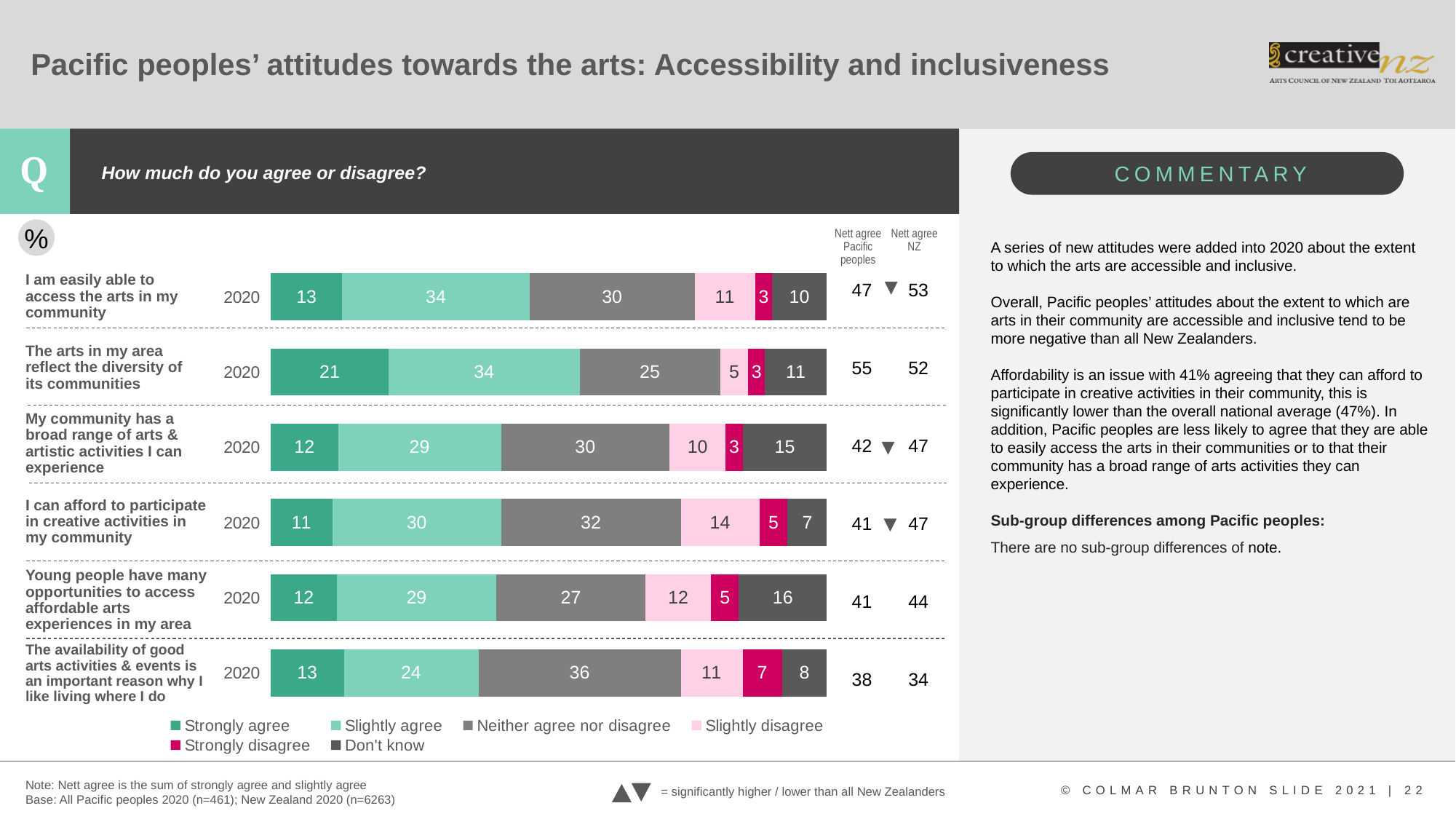
What is the Neither agree nor disagree value for "The availability of good arts activities & events is an important reason why I like living where I do"? 36 Which has the larger Neither agree nor disagree value: "I can afford to participate in creative activities in my community" or "Young people have many opportunities to access affordable arts experiences in my area"? I can afford to participate in creative activities in my community What is the Nett agree NZ value for "The availability of good arts activities & events is an important reason why I like living where I do"? 34 Which statement has the lowest Nett agree Pacific peoples value? The availability of good arts activities & events is an important reason why I like living where I do What kind of chart is shown on the slide? Stacked bar chart What is the Don't know value for "My community has a broad range of arts & artistic activities I can experience"? 15 Which statement has the highest Strongly disagree value? The availability of good arts activities & events is an important reason why I like living where I do What is the Strongly agree value for "I am easily able to access the arts in my community"? 13 What is the difference between the Slightly agree values for "I am easily able to access the arts in my community" and "The availability of good arts activities & events is an important reason why I like living where I do"? 10 How many series does the legend list? 6 How many statements are shown in the chart? 6 Which statement has the highest Strongly agree value? The arts in my area reflect the diversity of its communities